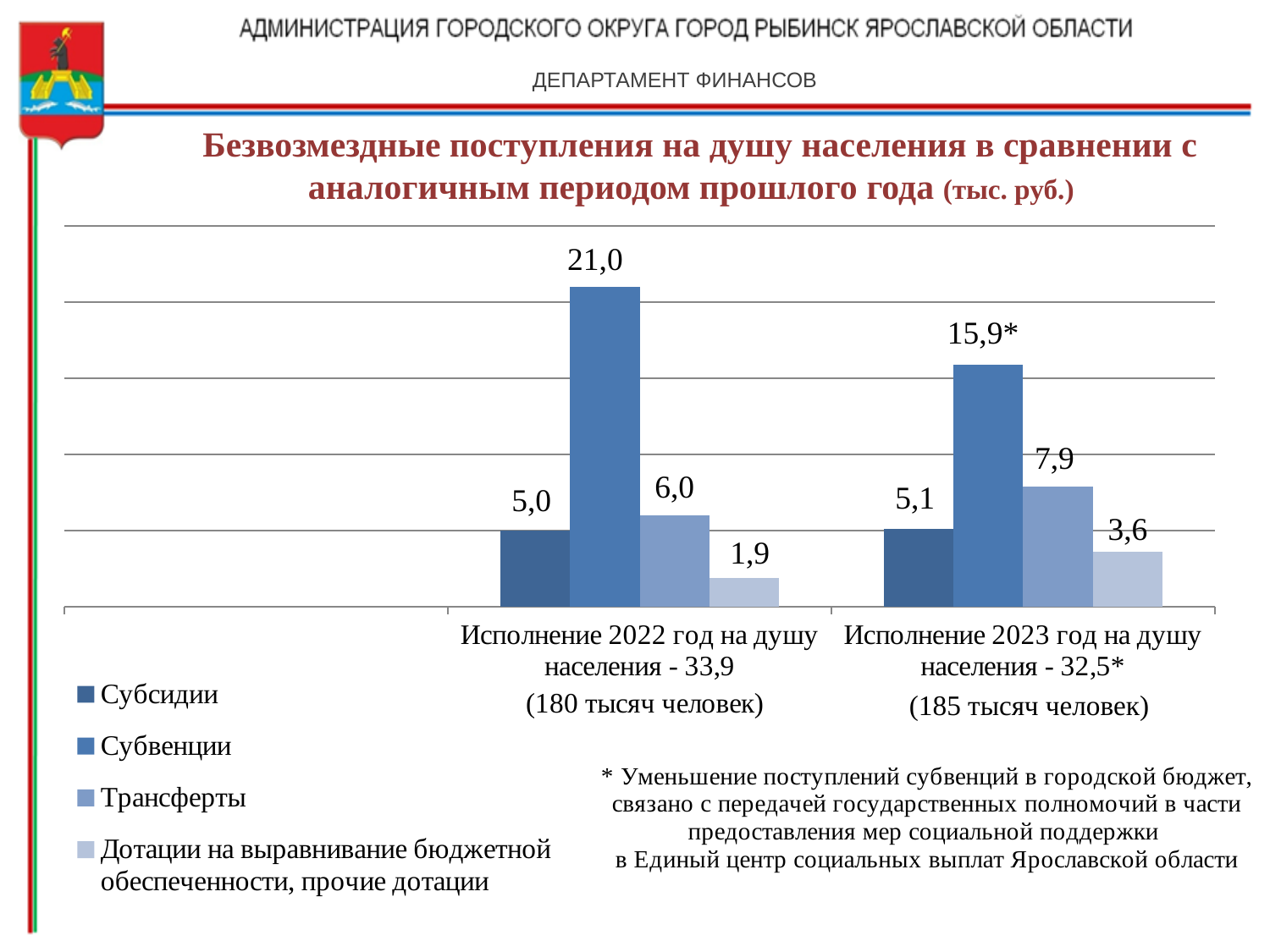
Каково значение дотаций на выравнивание бюджетной обеспеченности, прочих дотаций за 2022 год? 1,9 Какое общее значение безвозмездных поступлений на душу населения указано для 2023 года? 32,5* Каково значение трансфертов на душу населения за 2023 год? 7,9 Каково значение субвенций на душу населения за 2022 год? 21,0 Какая серия имеет наименьшее значение в категории «Исполнение 2023 год»? Дотации на выравнивание бюджетной обеспеченности, прочие дотации Какая серия имеет наибольшее значение в категории «Исполнение 2022 год»? Субвенции Как изменилось значение субвенций от 2022 года к 2023 году — выросло или снизилось? снизилось Сколько серий перечислено в легенде диаграммы? 4 На сколько значение субвенций за 2022 год больше значения субвенций за 2023 год? 5,1 Какой тип диаграммы показан на слайде? столбчатая (bar chart) Сколько категорий (периодов) показано на оси x диаграммы? 2 Что больше: трансферты за 2022 год или трансферты за 2023 год? трансферты за 2023 год